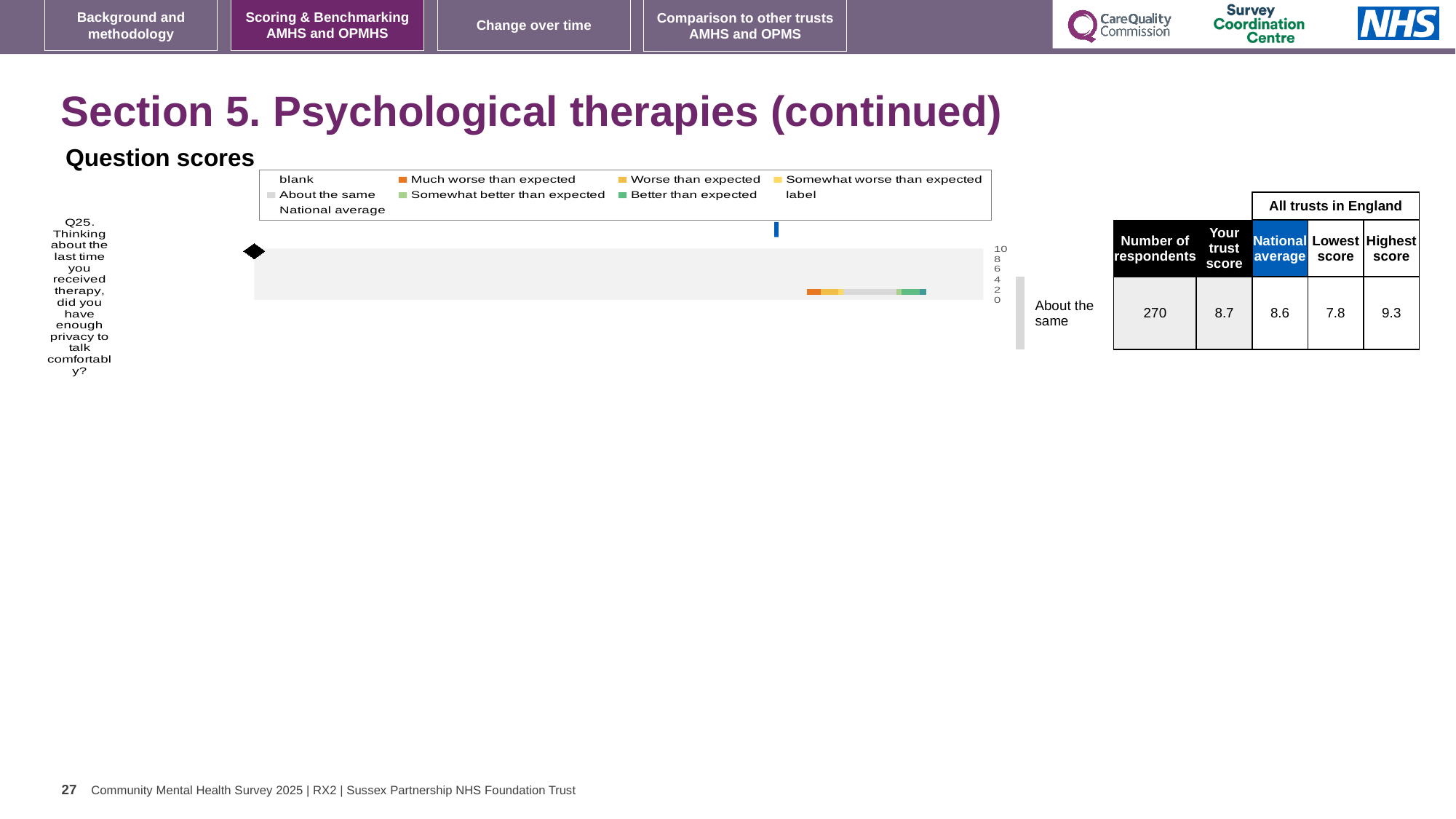
In the table beside the chart, which is larger for Q25: your trust score or the national average? Your trust score What is the highest tick value shown on the chart's axis? 10 In the table beside the chart, what is 'Your trust score' for Q25? 8.7 In the table beside the chart, what is the number of respondents for Q25? 270 What kind of chart is shown under 'Question scores'? bar chart What benchmark category is shown next to the bar for Q25? About the same In the table beside the chart, what is the difference between the highest score and the lowest score for Q25? 1.5 In the table beside the chart, what is the highest score among all trusts in England for Q25? 9.3 In the table beside the chart, what is the national average for Q25? 8.6 In the table beside the chart, what is the lowest score among all trusts in England for Q25? 7.8 Which question number is plotted in the chart? Q25 In the table beside the chart, what is the difference between your trust score and the national average for Q25? 0.1